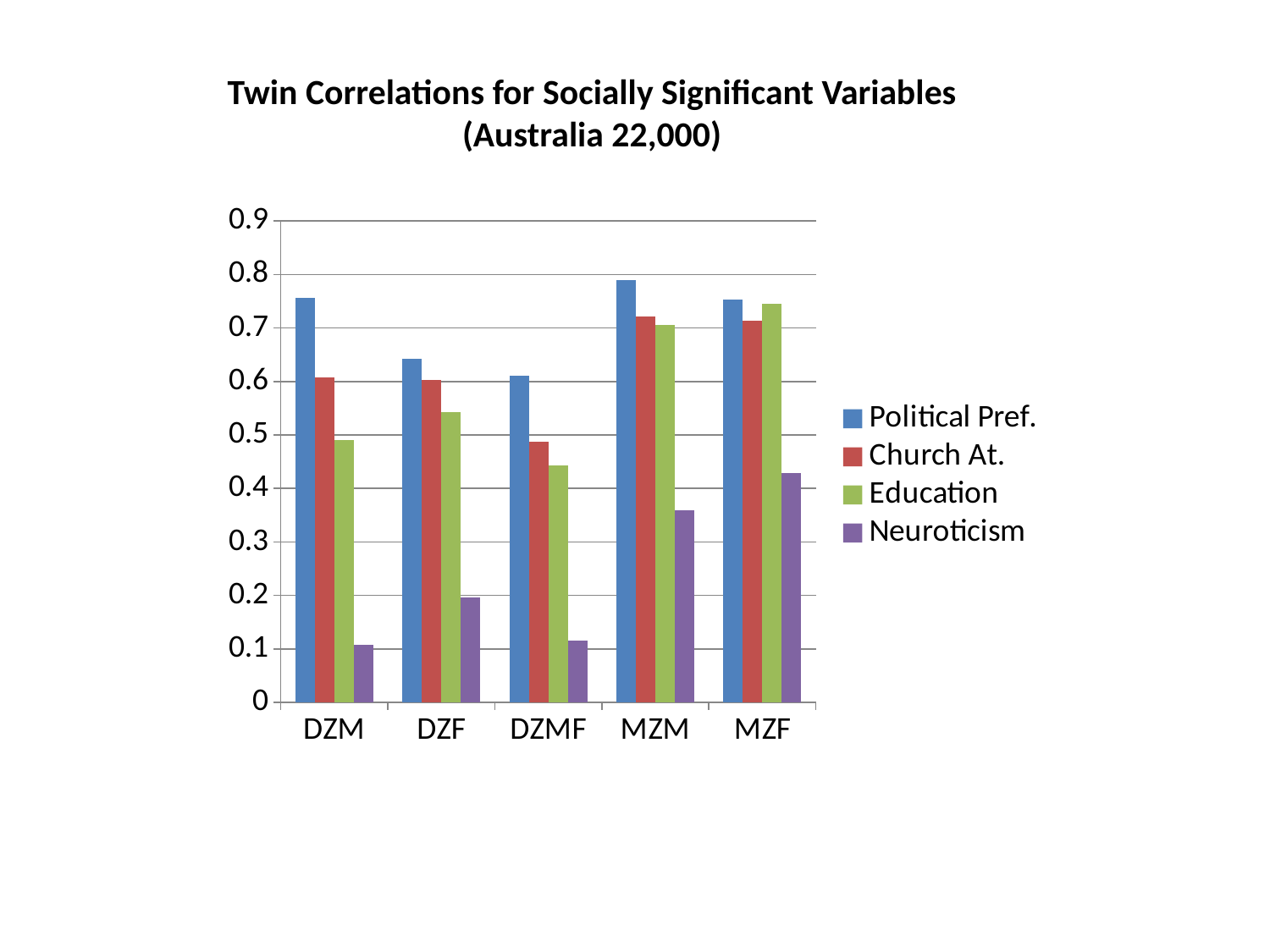
Which category has the highest Political Pref. value? MZM What kind of chart is shown on the slide? bar chart What is the title of the chart? Twin Correlations for Socially Significant Variables (Australia 22,000) Is the Political Pref. value for DZM greater or less than 0.7? greater Which category has the lowest Education value? DZMF How many categories are shown on the x axis? 5 Is the Neuroticism value for MZM greater or less than 0.4? less How many series does the legend list? 4 Which is larger, the Political Pref. value for DZM or for DZF? DZM Which category has the highest Neuroticism value? MZF Which is larger, the Neuroticism value for MZF or for DZM? MZF Is the Education value for DZF greater or less than 0.5? greater